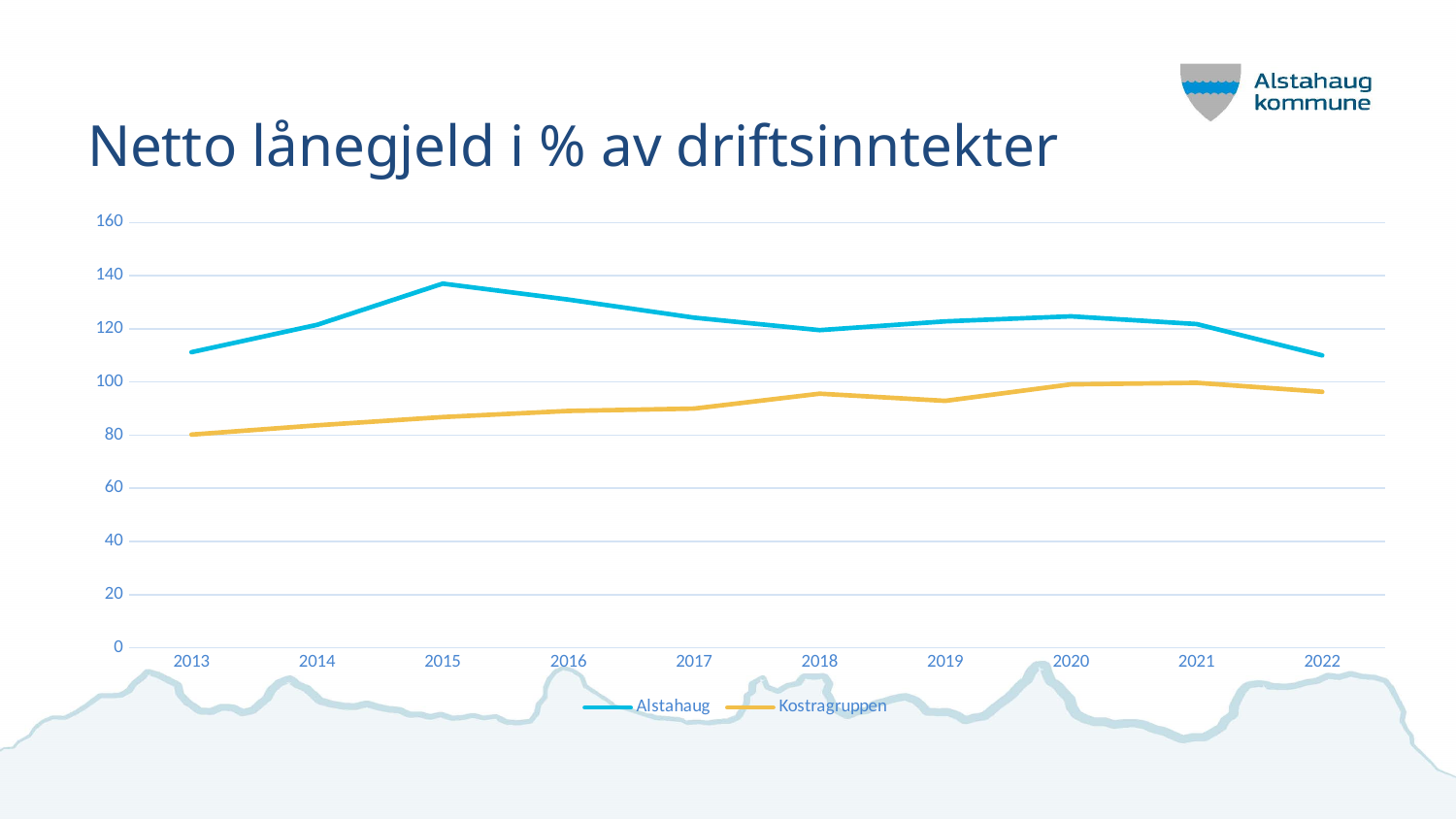
Is the value for Alstahaug in 2015 greater or less than 120? greater In which year is the Kostragruppen value lowest? 2013 In which year does the Alstahaug line reach its highest value? 2015 How many years are shown on the x axis? 10 Does the Kostragruppen line generally rise or fall from 2013 to 2020? rise Is the value for Kostragruppen in 2013 greater or less than 100? less What kind of chart is shown on the slide? line chart Is the value for Kostragruppen in 2018 greater or less than 100? less What is the title of the chart? Netto lånegjeld i % av driftsinntekter In 2018, which series has the higher value, Alstahaug or Kostragruppen? Alstahaug How many series does the legend list? 2